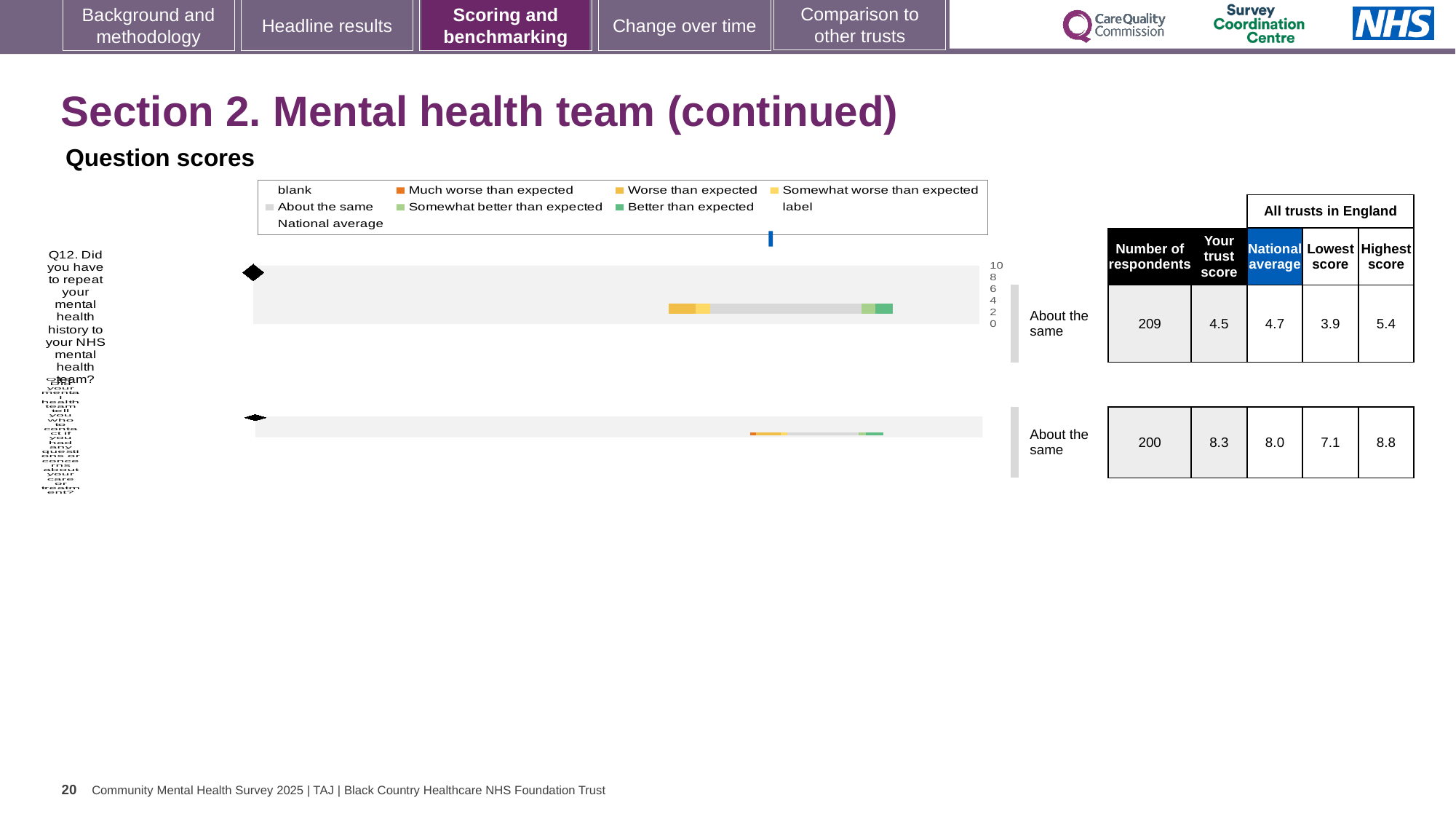
For the second (lower) question row, what is the difference between the highest score (8.8) and the lowest score (7.1) among all trusts in England? 1.7 How many question rows (bars) are plotted in the question scores chart? 2 For the second (lower) question row, what is the trust's score? 8.3 What kind of chart is used to show the question scores on this slide? bar chart What is the difference between the national average and the trust's score for Q12? 0.2 What benchmark category is shown beside the Q12 bar? About the same What is the national average score for Q12 shown in the table? 4.7 In the table next to the chart, what is the trust's score for Q12 (repeating mental health history to the NHS mental health team)? 4.5 In the chart legend, what colour represents 'Much worse than expected'? Orange For Q12, which is larger: the trust's score or the national average? National average How many respondents answered Q12 according to the table? 209 What is the highest score among all trusts in England for Q12? 5.4